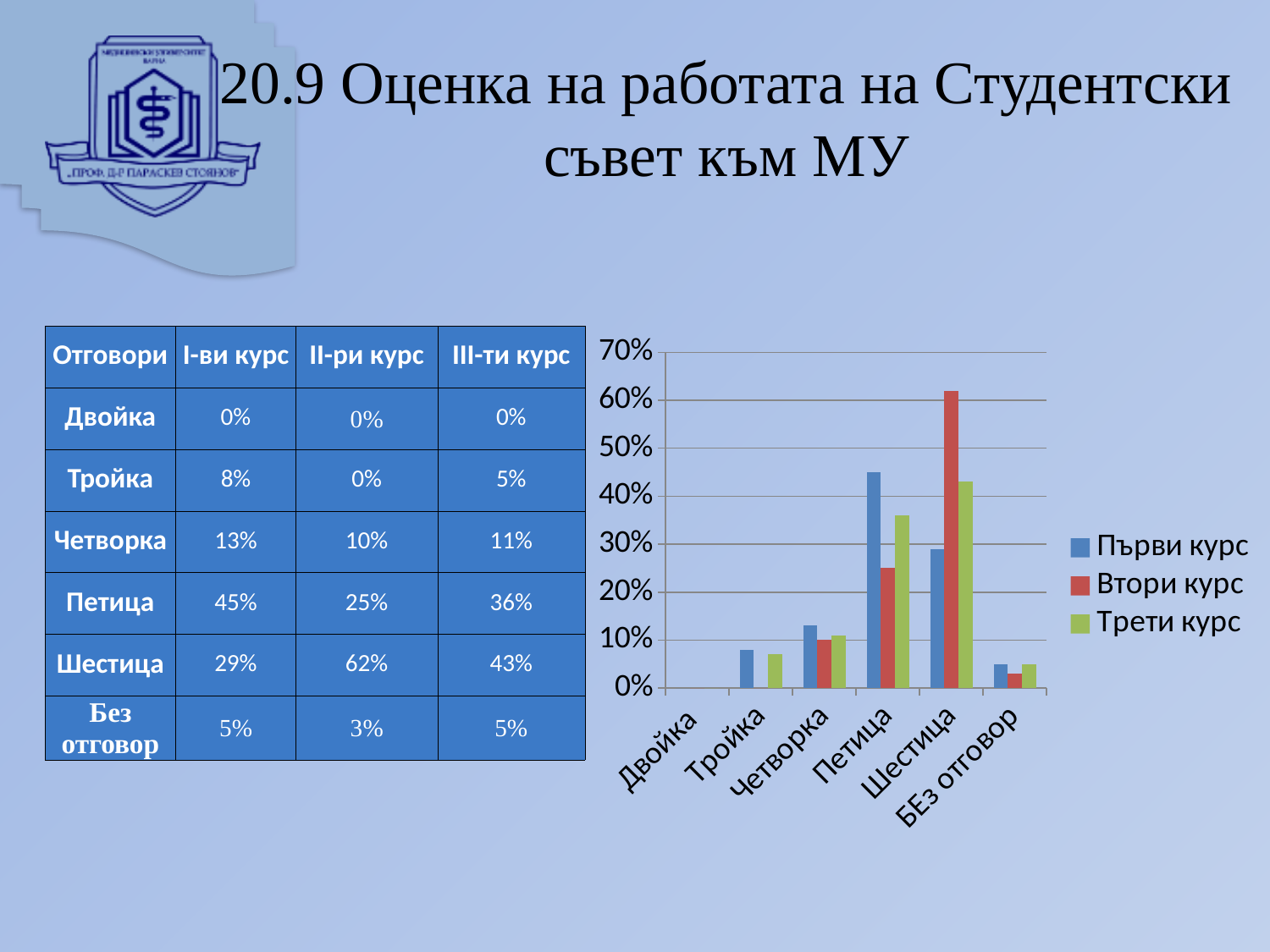
What is the difference between Втори курс and Първи курс in the Шестица category? 33% Is the value for Втори курс in the Шестица category greater or less than 60%? greater Which is larger in the Петица category: Първи курс or Втори курс? Първи курс Which category has the highest value for Първи курс? Петица Which series is shown in red in the chart legend? Втори курс What is the value for Втори курс in the Шестица category? 62% Is the value for Първи курс in the Петица category greater or less than 40%? greater How many categories are shown on the x axis of the chart? 6 What is the value for Трети курс in the Петица category? 36% How many series does the chart legend list? 3 What kind of chart is shown on the slide? bar chart Which category has the highest value for Втори курс? Шестица